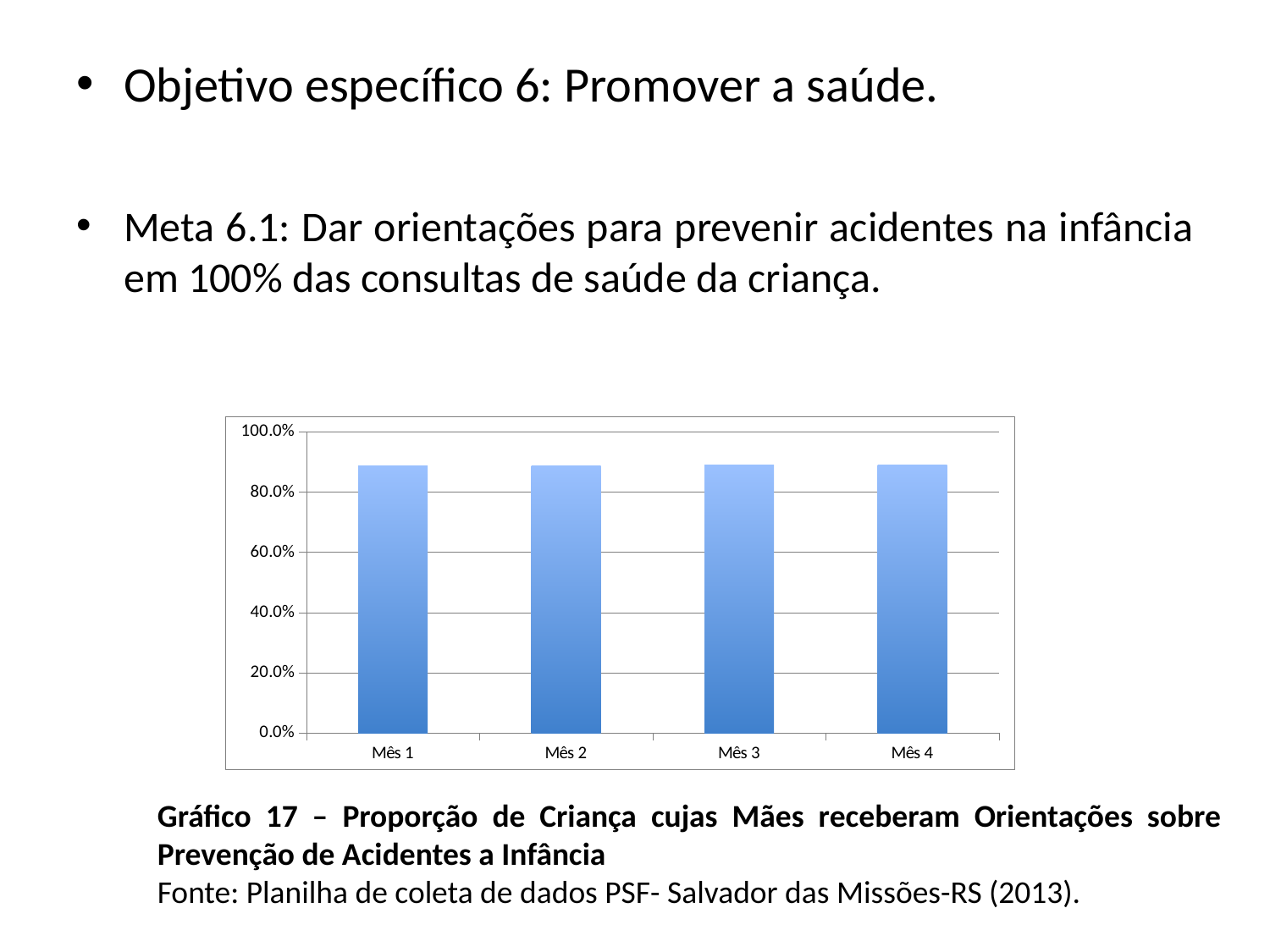
Is the value for Mês 3 greater or less than 60.0%? greater Is the value for Mês 2 greater or less than 100.0%? less Is the value for Mês 4 greater or less than 80.0%? greater How many categories (months) are plotted on the chart? 4 What is the highest value shown on the vertical axis of the chart? 100.0% What kind of chart is shown on the slide? bar chart Do the values rise, fall, or stay roughly level from Mês 1 to Mês 4? stay roughly level What is the label of the first category on the horizontal axis? Mês 1